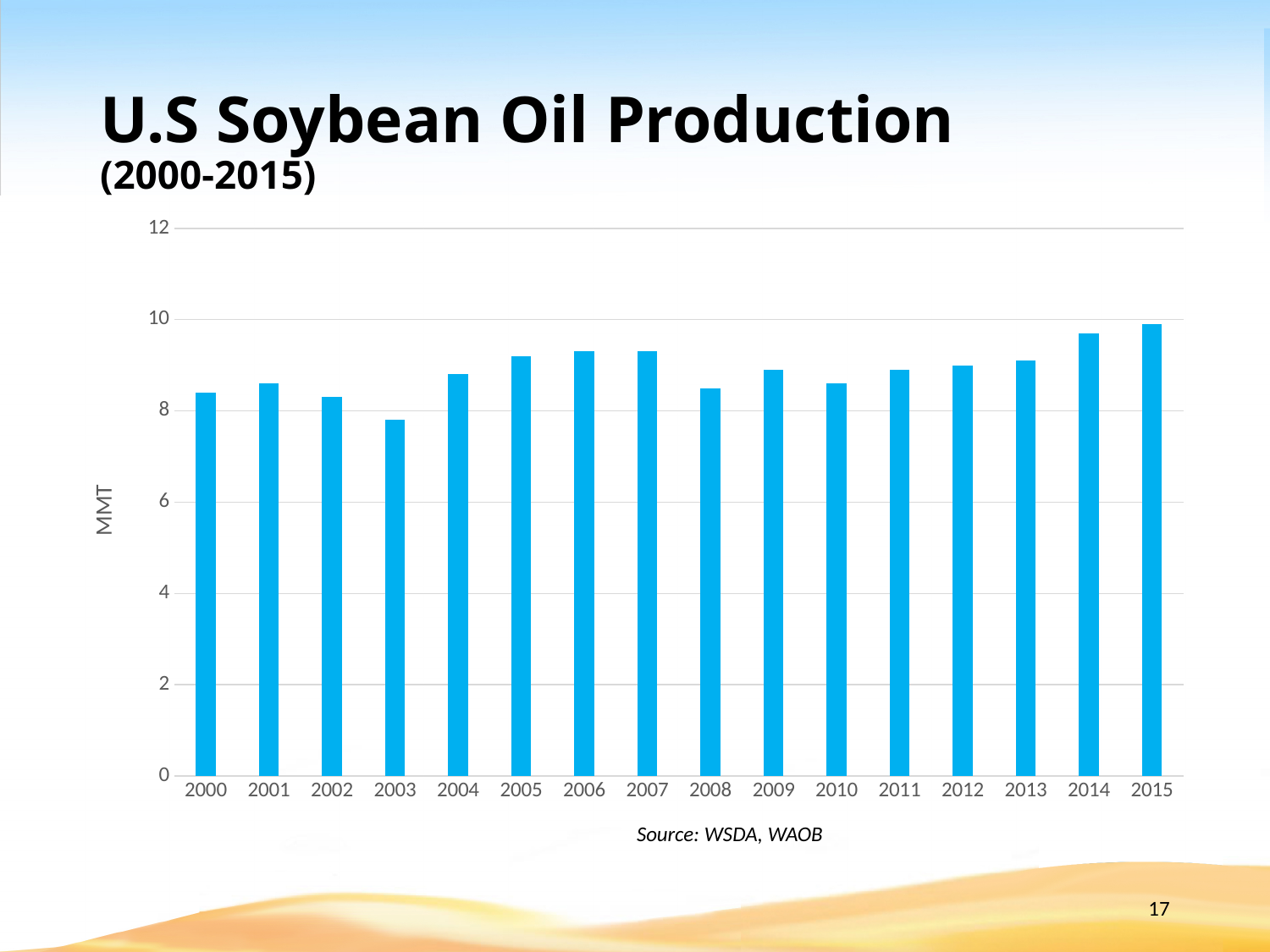
Which year has the highest soybean oil production? 2015 Is the value for 2003 greater or less than 8? less How many years are plotted on the chart? 16 What unit is shown on the vertical axis label? MMT Do the values rise or fall from 2008 to 2015? rise Which is larger, the value for 2003 or the value for 2005? 2005 What source is cited below the chart? WSDA, WAOB Which is larger, the value for 2014 or the value for 2008? 2014 Which year has the lowest soybean oil production? 2003 What kind of chart is shown on the slide? bar chart Is the value for 2006 greater or less than 8? greater